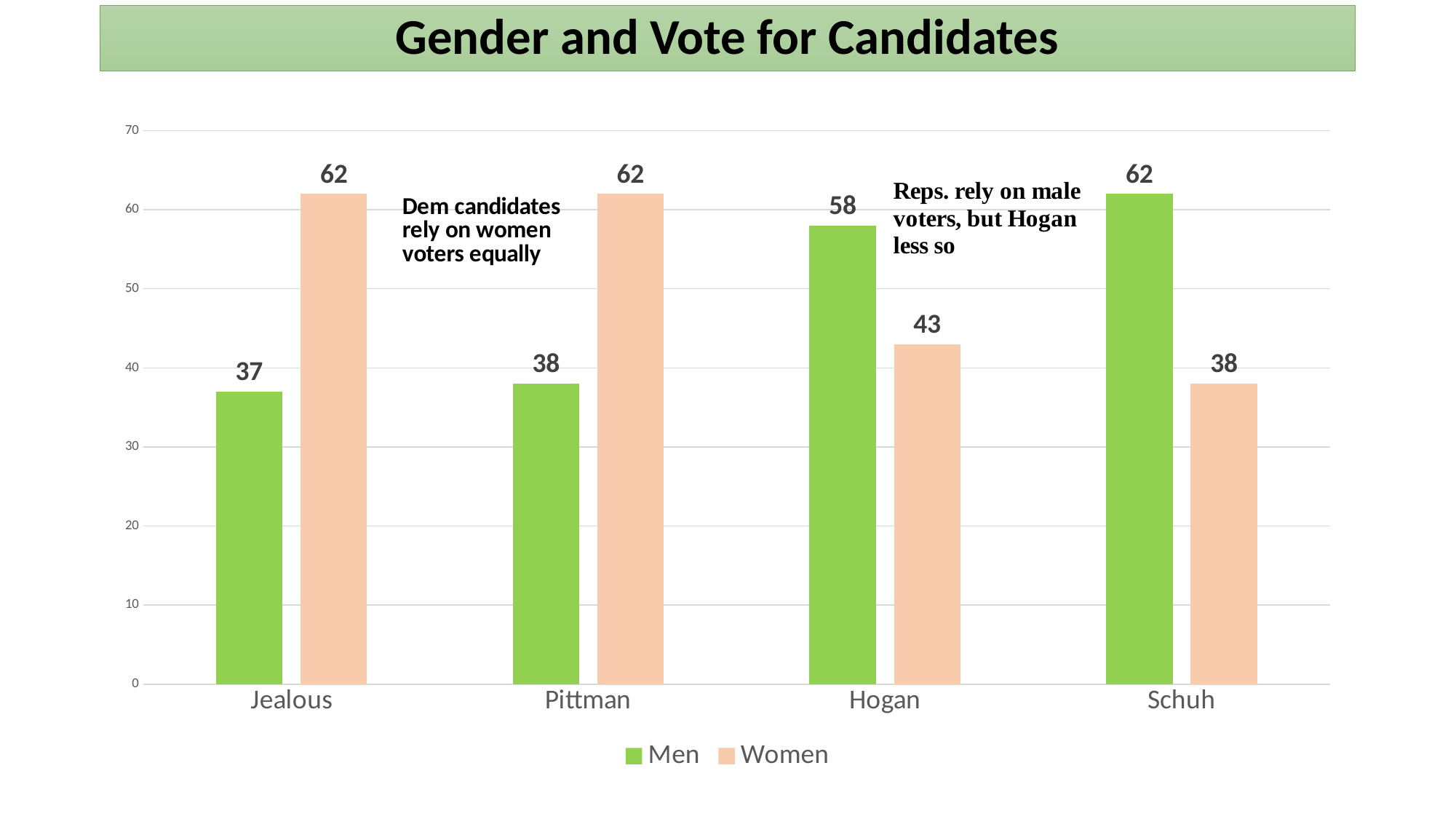
What is the value for Men for Schuh? 62 What is the value for Women for Pittman? 62 What is the value for Women for Hogan? 43 What kind of chart is shown on the slide? Bar chart Which candidate has the lowest value for Men? Jealous How many series does the legend list? 2 What is the value for Men for Jealous? 37 What is the difference between the Women and Men values for Hogan? 15 What is the difference between the Women and Men values for Jealous? 25 Which candidate has the lowest value for Women? Schuh Which is larger for Schuh, the Men value or the Women value? Men How many candidates are shown on the x axis? 4